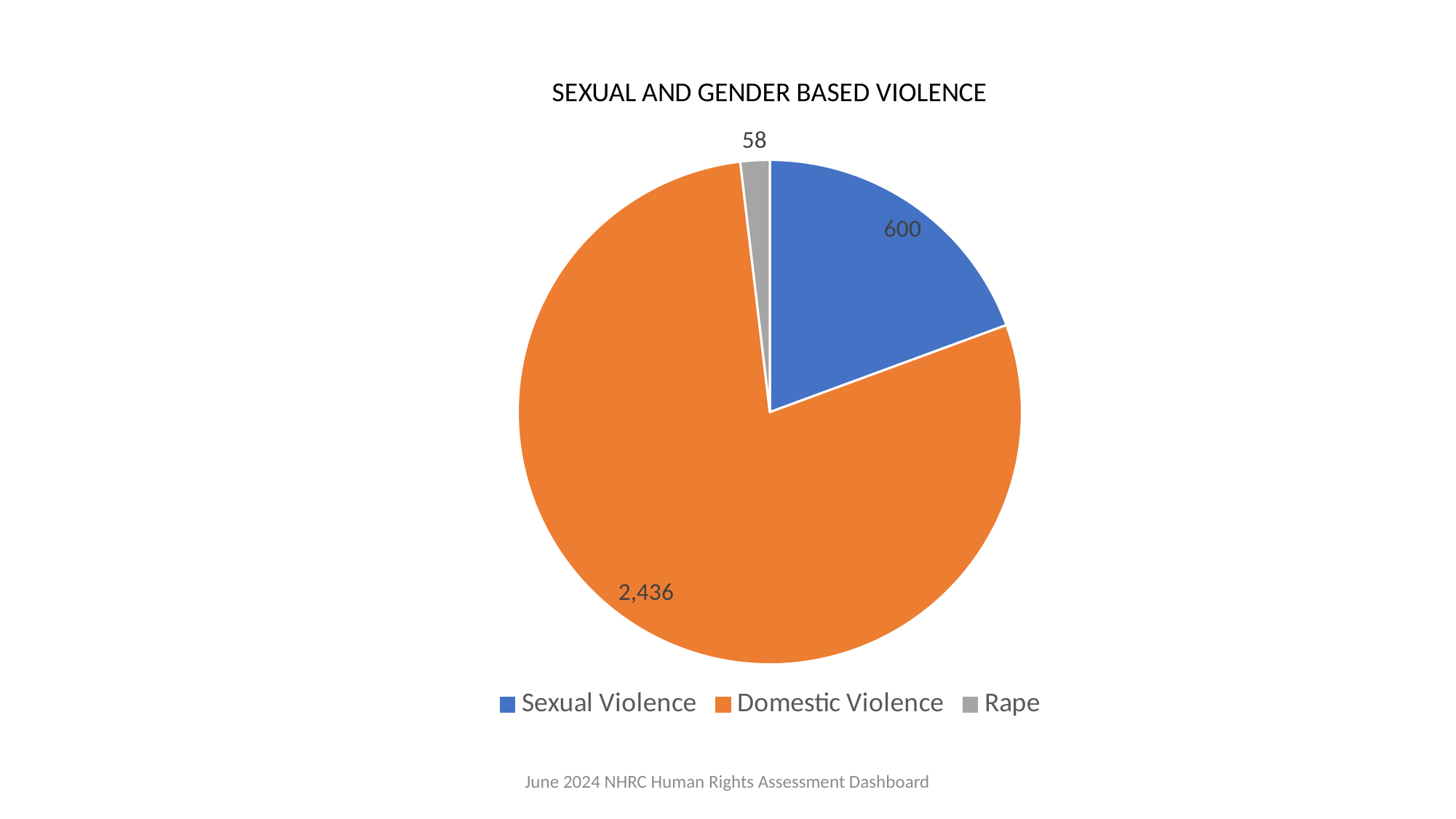
Which category has the smallest slice of the pie? Rape What is the difference between the values for Domestic Violence and Sexual Violence? 1,836 What is the value for Rape? 58 What is the title of the chart? SEXUAL AND GENDER BASED VIOLENCE What is the value for Sexual Violence? 600 What is the total of all three slices in the pie chart? 3,094 What kind of chart is shown on the slide? Pie chart Which is larger, the value for Sexual Violence or the value for Rape? Sexual Violence How many categories does the pie chart show? 3 What is the difference between the values for Sexual Violence and Rape? 542 What is the value for Domestic Violence? 2,436 Which category has the largest slice of the pie? Domestic Violence